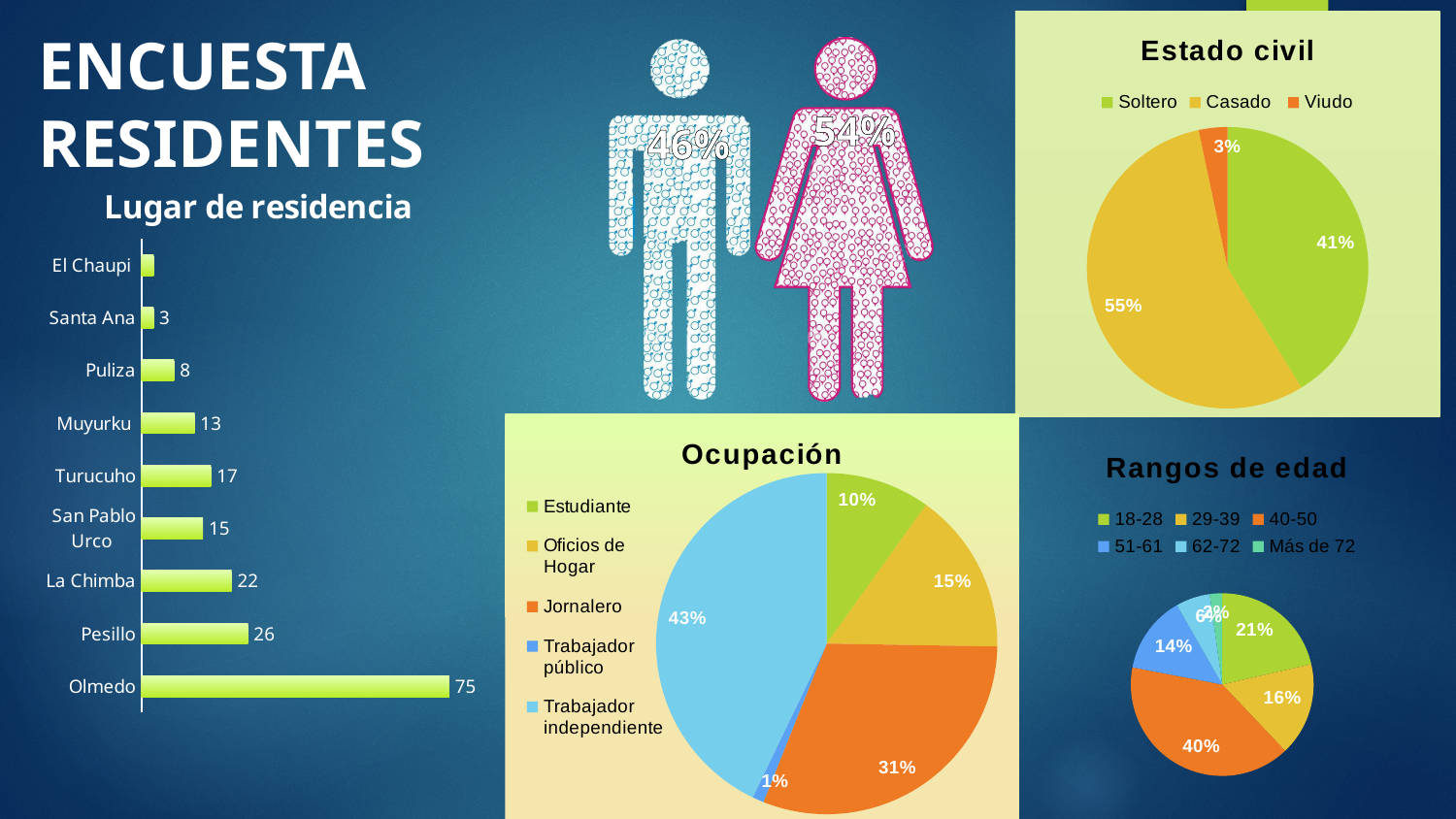
How many categories does the legend of the 'Ocupación' pie chart list? 5 How many places are shown in the 'Lugar de residencia' bar chart? 9 In the 'Estado civil' pie chart, which category has the smallest share? Viudo In the 'Lugar de residencia' bar chart, what is the value for Olmedo? 75 In the 'Lugar de residencia' bar chart, what is the value for La Chimba? 22 In the 'Estado civil' pie chart, what share is Casado? 55% In the 'Lugar de residencia' bar chart, which place has the highest value? Olmedo What kind of chart is 'Lugar de residencia'? Bar chart In the 'Rangos de edad' pie chart, what share is the 40-50 range? 40% In the 'Lugar de residencia' bar chart, which is larger, the value for Turucuho or the value for San Pablo Urco? Turucuho In the 'Ocupación' pie chart, what share is Jornalero? 31% In the 'Lugar de residencia' bar chart, what is the difference between the values for Pesillo and Puliza? 18